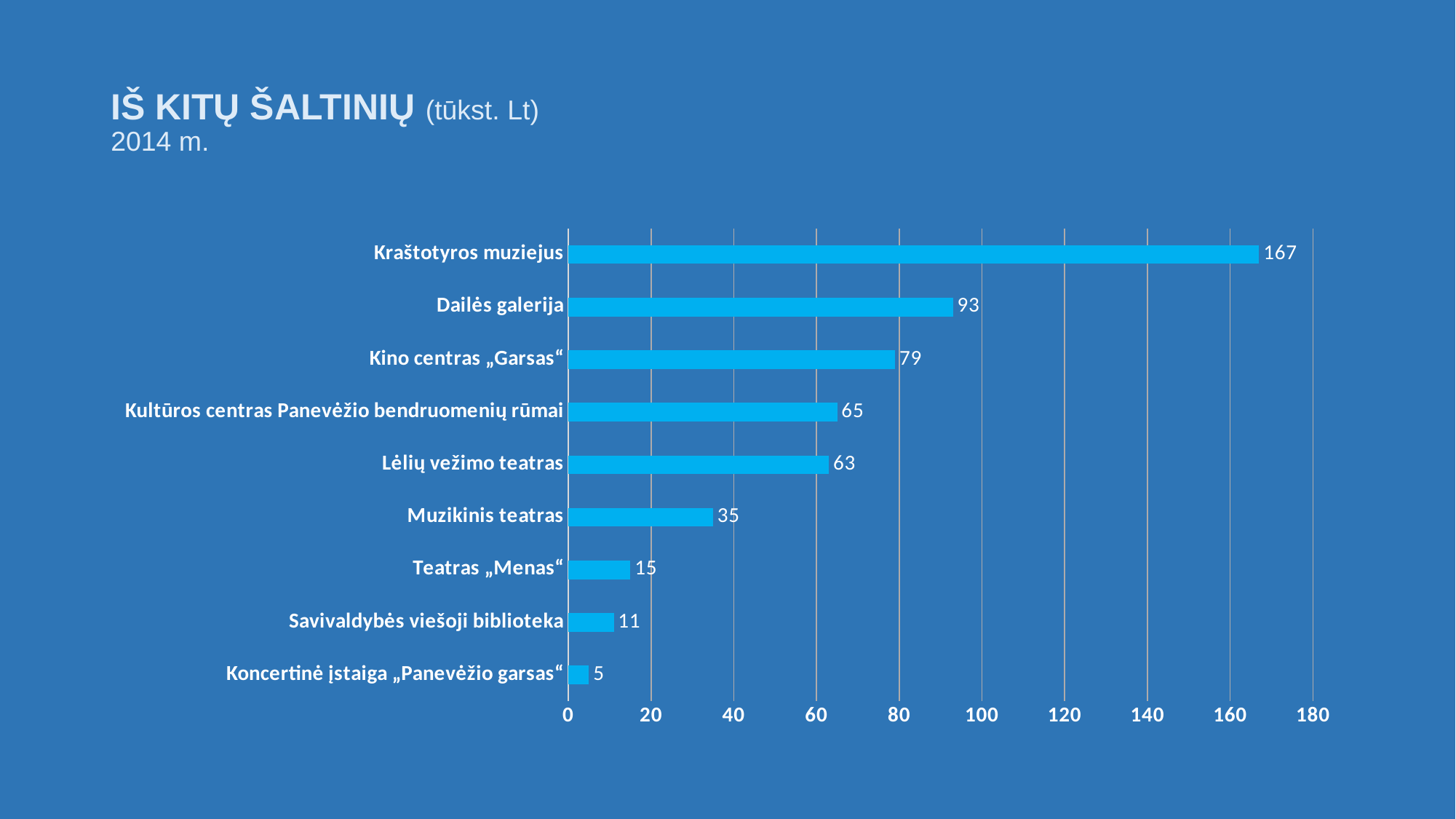
What is the value for Kraštotyros muziejus? 167 What is the value for Savivaldybės viešoji biblioteka? 11 What is the difference between the values for Kraštotyros muziejus and Dailės galerija? 74 Which category has the highest value? Kraštotyros muziejus What kind of chart is shown on the slide? bar chart Is the value for Kultūros centras Panevėžio bendruomenių rūmai greater or less than 80? less What is the value for Lėlių vežimo teatras? 63 How many categories are shown in the chart? 9 What is the value for Dailės galerija? 93 Which category has the lowest value? Koncertinė įstaiga „Panevėžio garsas“ What is the title of the chart? IŠ KITŲ ŠALTINIŲ (tūkst. Lt) 2014 m. Which is larger, the value for Kino centras „Garsas“ or the value for Muzikinis teatras? Kino centras „Garsas“